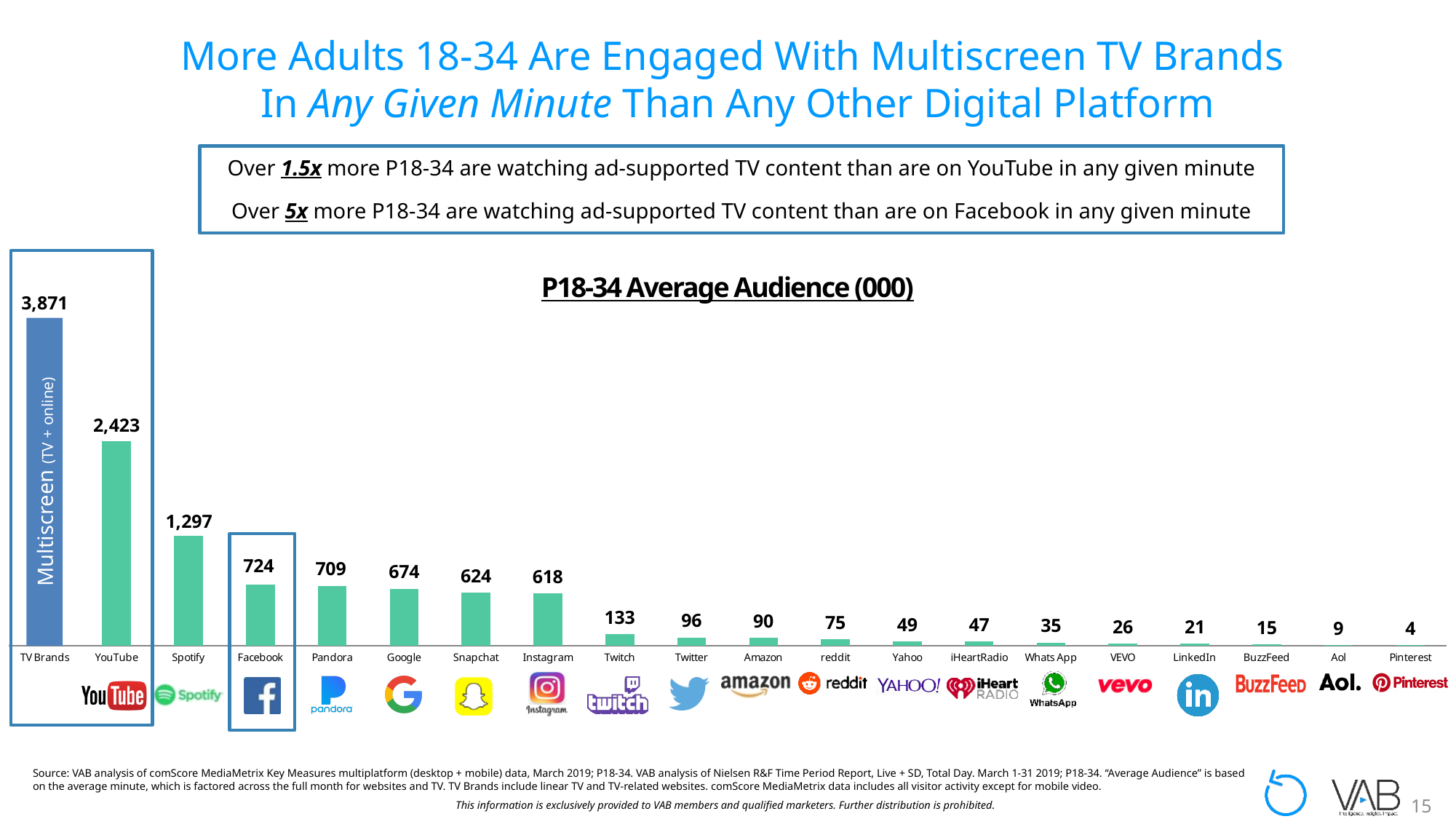
What is the P18-34 average audience (000) for Facebook? 724 What is the difference between the TV Brands value and the YouTube value? 1,448 What is the P18-34 average audience (000) for YouTube? 2,423 What is the P18-34 average audience (000) for Twitch? 133 Which has a larger P18-34 average audience, Twitter or Amazon? Twitter Which category has the lowest P18-34 average audience? Pinterest Which category has the highest P18-34 average audience? TV Brands What is the title of the chart? P18-34 Average Audience (000) Which has a larger P18-34 average audience, Pandora or Google? Pandora How many categories are shown in the chart? 20 What is the difference between the Spotify value and the Facebook value? 573 What type of chart is shown on the slide? Bar chart